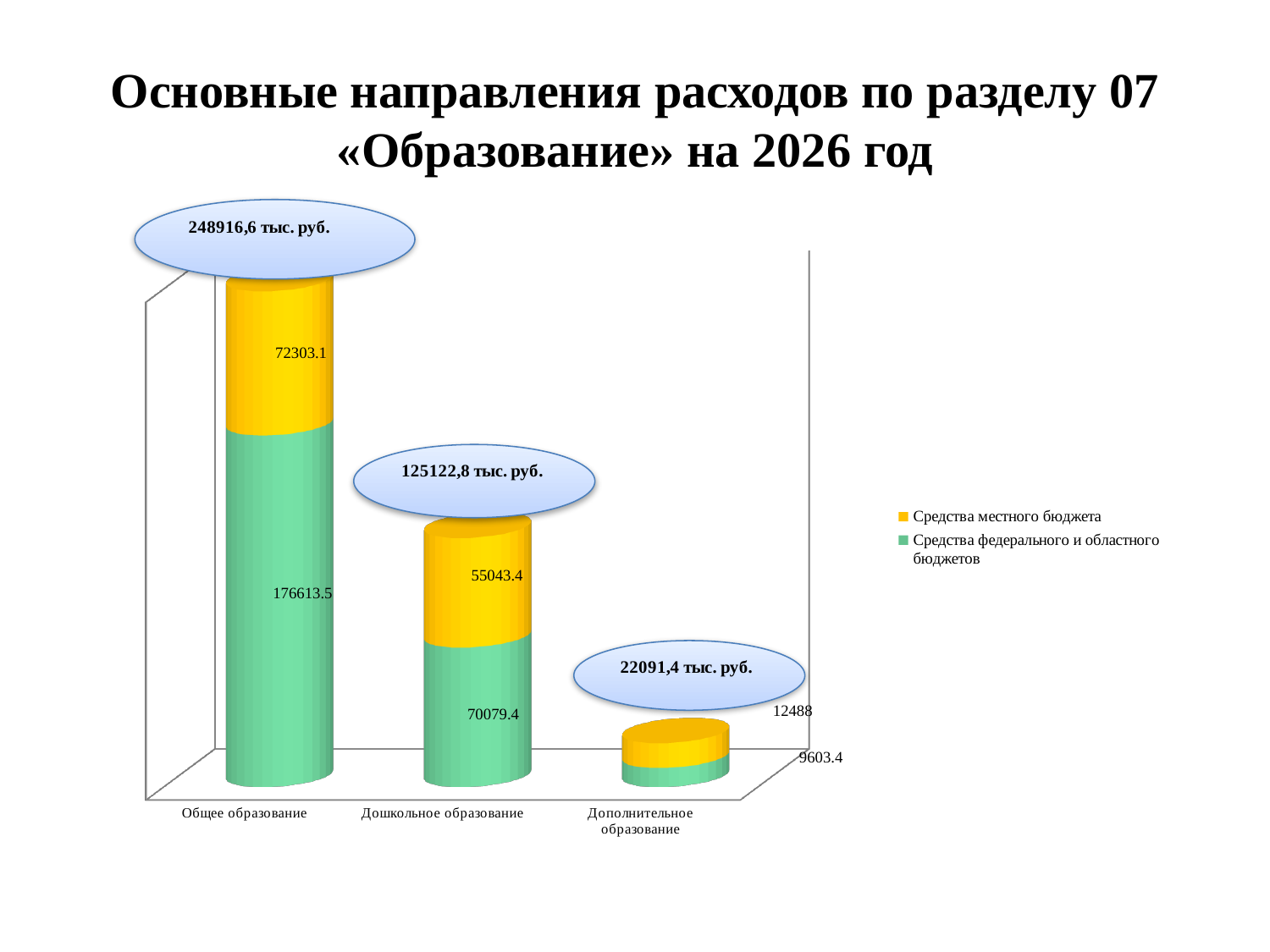
Which category has the highest total expenditure? Общее образование What is the value of Средства местного бюджета for Общее образование? 72303.1 What kind of chart is shown on the slide? Stacked bar chart Which colour represents Средства местного бюджета in the chart? Yellow How many categories are shown on the x axis of the chart? 3 What is the total shown for the Дошкольное образование bar? 125122,8 тыс. руб. How many series does the chart legend list? 2 What is the value of Средства федерального и областного бюджетов for Общее образование? 176613.5 What is the difference between Средства федерального и областного бюджетов and Средства местного бюджета for Дошкольное образование? 15036 What is the value of Средства местного бюджета for Дошкольное образование? 55043.4 What is the value of Средства федерального и областного бюджетов for Дополнительное образование? 9603.4 Which category has the lowest total expenditure? Дополнительное образование